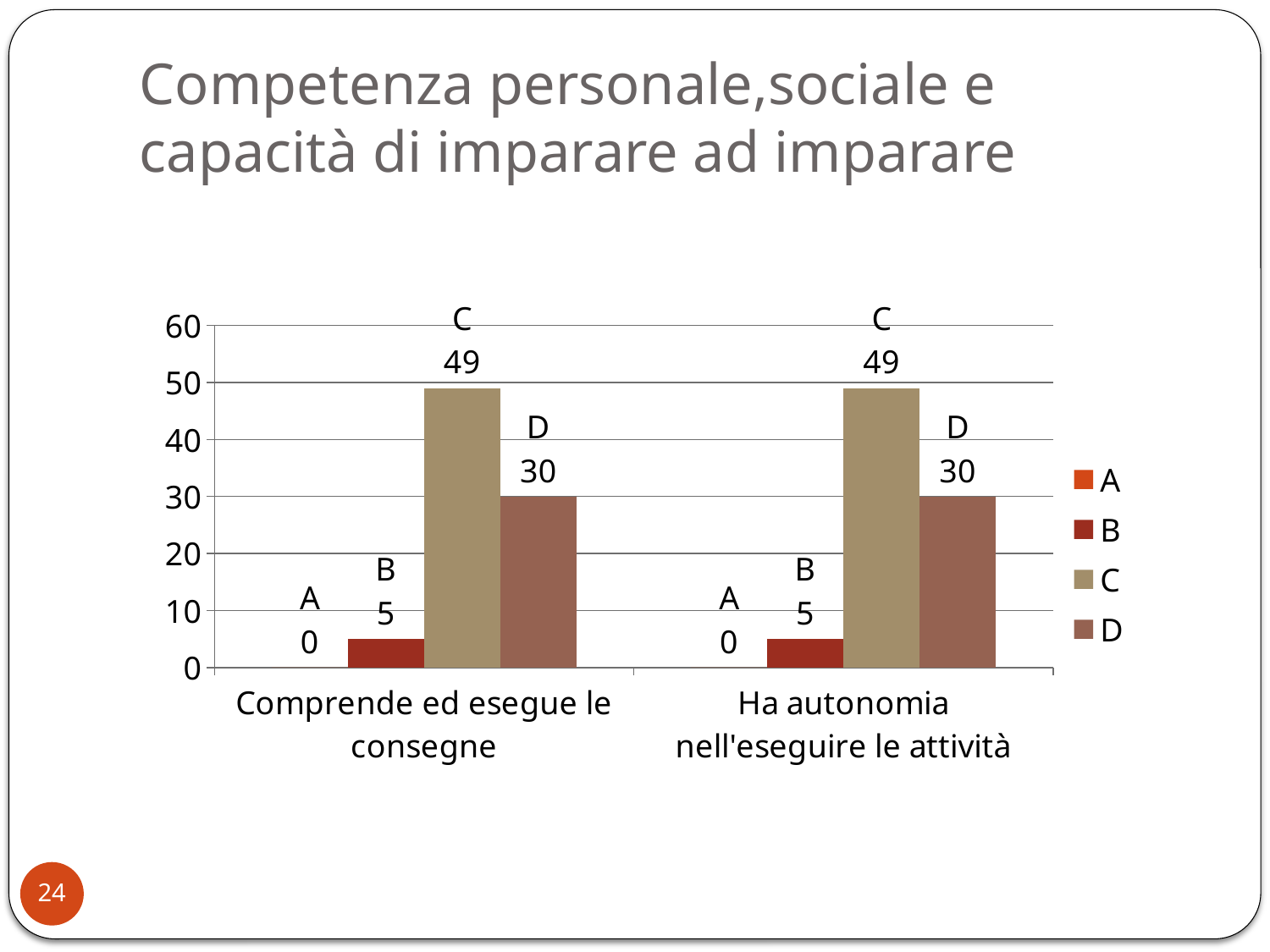
Which series has the lowest value in the category "Comprende ed esegue le consegne"? A In the category "Ha autonomia nell'eseguire le attività", which is larger: the value for series B or the value for series D? D What is the highest value shown on the vertical axis? 60 How many categories are shown on the x axis? 2 What is the difference between the values for series C and series D in the category "Comprende ed esegue le consegne"? 19 How many series does the legend list? 4 Which series has the highest value in the category "Ha autonomia nell'eseguire le attività"? C What is the value for series C in the category "Comprende ed esegue le consegne"? 49 What is the value for series B in the category "Comprende ed esegue le consegne"? 5 What is the value for series A in the category "Ha autonomia nell'eseguire le attività"? 0 What is the value for series D in the category "Ha autonomia nell'eseguire le attività"? 30 What kind of chart is shown on the slide? Bar chart